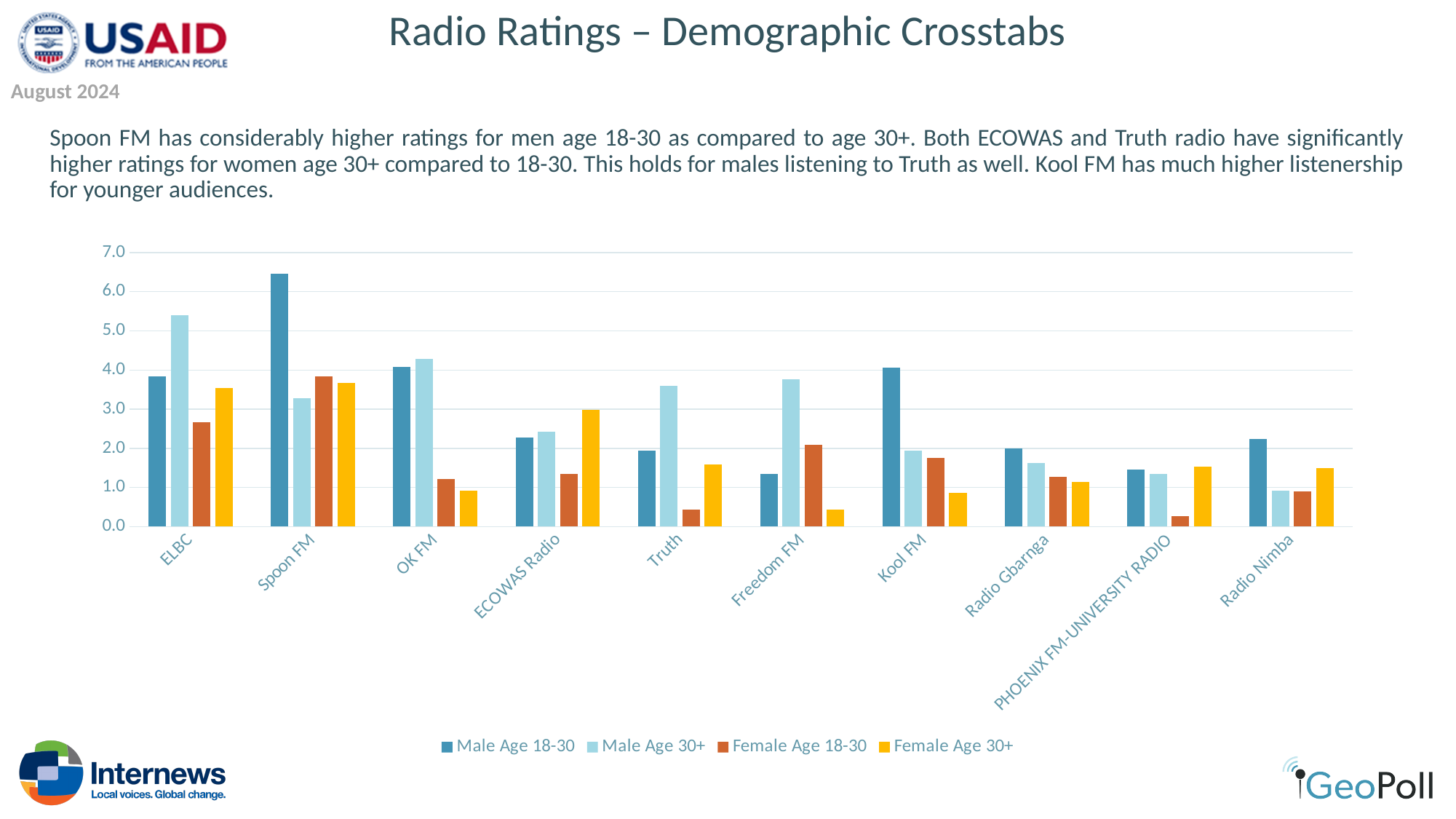
For Kool FM, which is larger: the Male Age 18-30 rating or the Male Age 30+ rating? Male Age 18-30 Is the Female Age 18-30 rating for Truth greater or less than 1.0? less Which radio station has the lowest rating for Female Age 18-30? PHOENIX FM-UNIVERSITY RADIO How many radio stations are shown on the x axis of the chart? 10 Is the Male Age 18-30 rating for Spoon FM greater or less than 6.0? greater Which radio station has the highest rating for Male Age 18-30? Spoon FM How many series does the chart's legend list? 4 What kind of chart is shown on the slide? bar chart For Truth, which is larger: the Male Age 30+ rating or the Male Age 18-30 rating? Male Age 30+ Which radio station has the highest rating for Female Age 18-30? Spoon FM Which radio station has the highest rating for Male Age 30+? ELBC Which radio station has the lowest rating for Male Age 30+? Radio Nimba